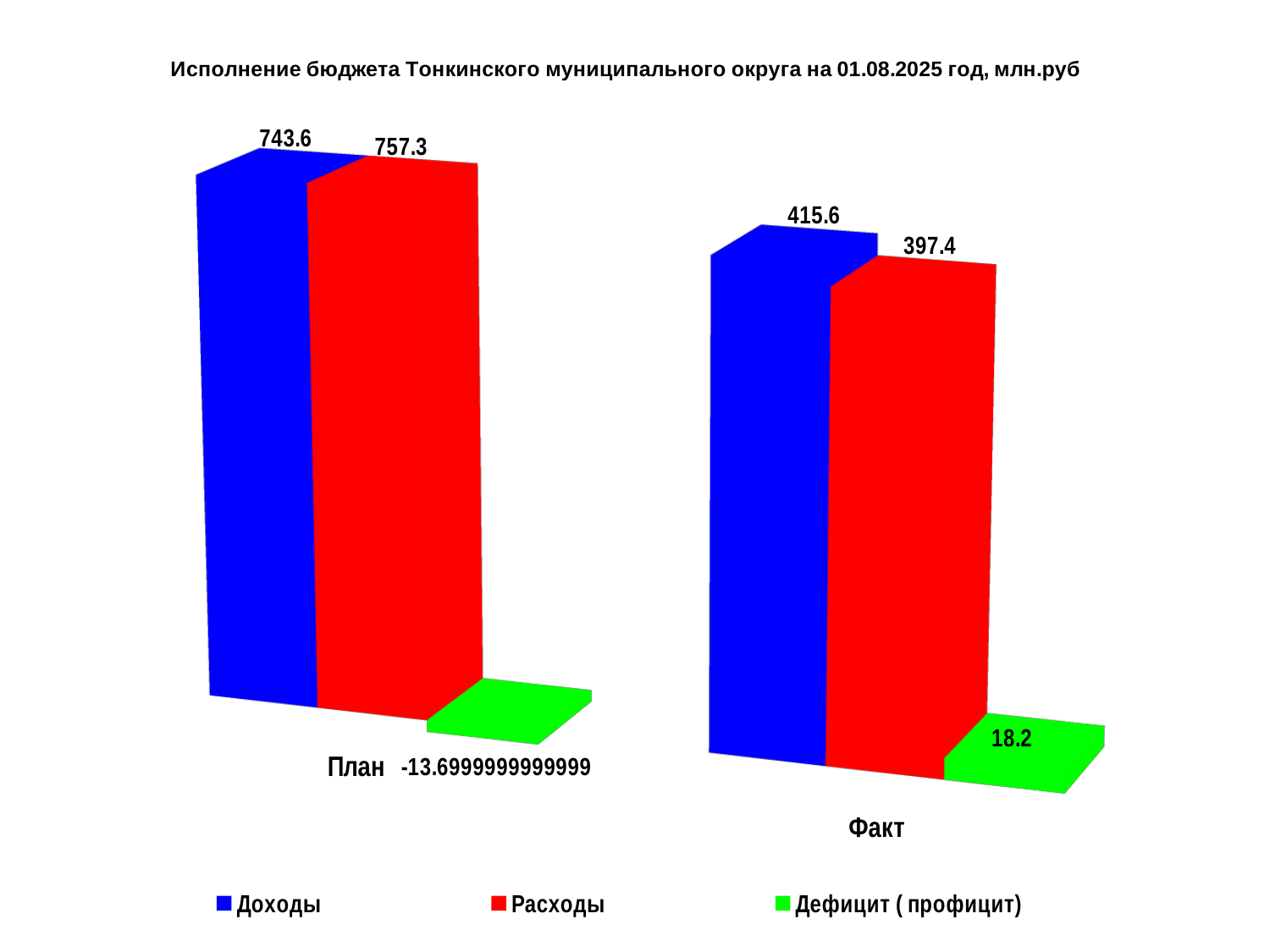
What is the value of Расходы for План? 757.3 Which is larger for План: Доходы or Расходы? Расходы What is the value of Доходы for Факт? 415.6 Which is larger for Факт: Доходы or Расходы? Доходы What is the value of Расходы for Факт? 397.4 What is the difference between Доходы and Расходы for Факт? 18.2 What is the difference between Доходы for План and Доходы for Факт? 328 How many series does the legend list? 3 What is the data label shown for Дефицит (профицит) for План? -13.6999999999999 What is the value of Доходы for План? 743.6 What is the value of Дефицит (профицит) for Факт? 18.2 What kind of chart is shown on the slide? Bar chart